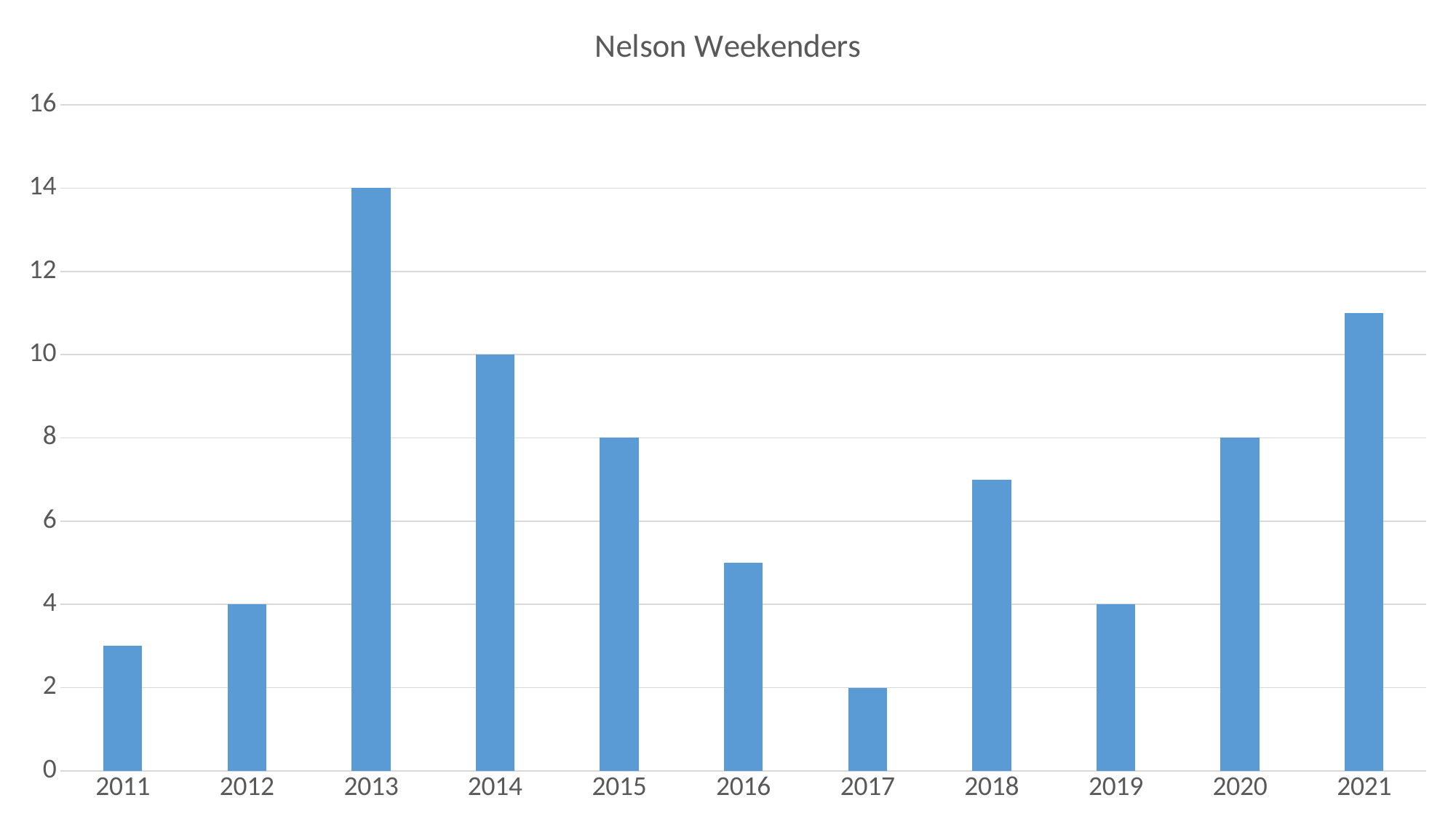
What is the value for 2017? 2 Is the value for 2011 greater or less than 4? less Which is larger, the value for 2018 or the value for 2019? 2018 What is the title of the chart? Nelson Weekenders What is the value for 2014? 10 What is the difference between the values for 2013 and 2014? 4 How many years are shown on the x axis? 11 Is the value for 2021 greater or less than 10? greater What type of chart is shown on the slide? bar chart What is the value for 2013? 14 Which year has the highest value? 2013 Which year has the lowest value? 2017